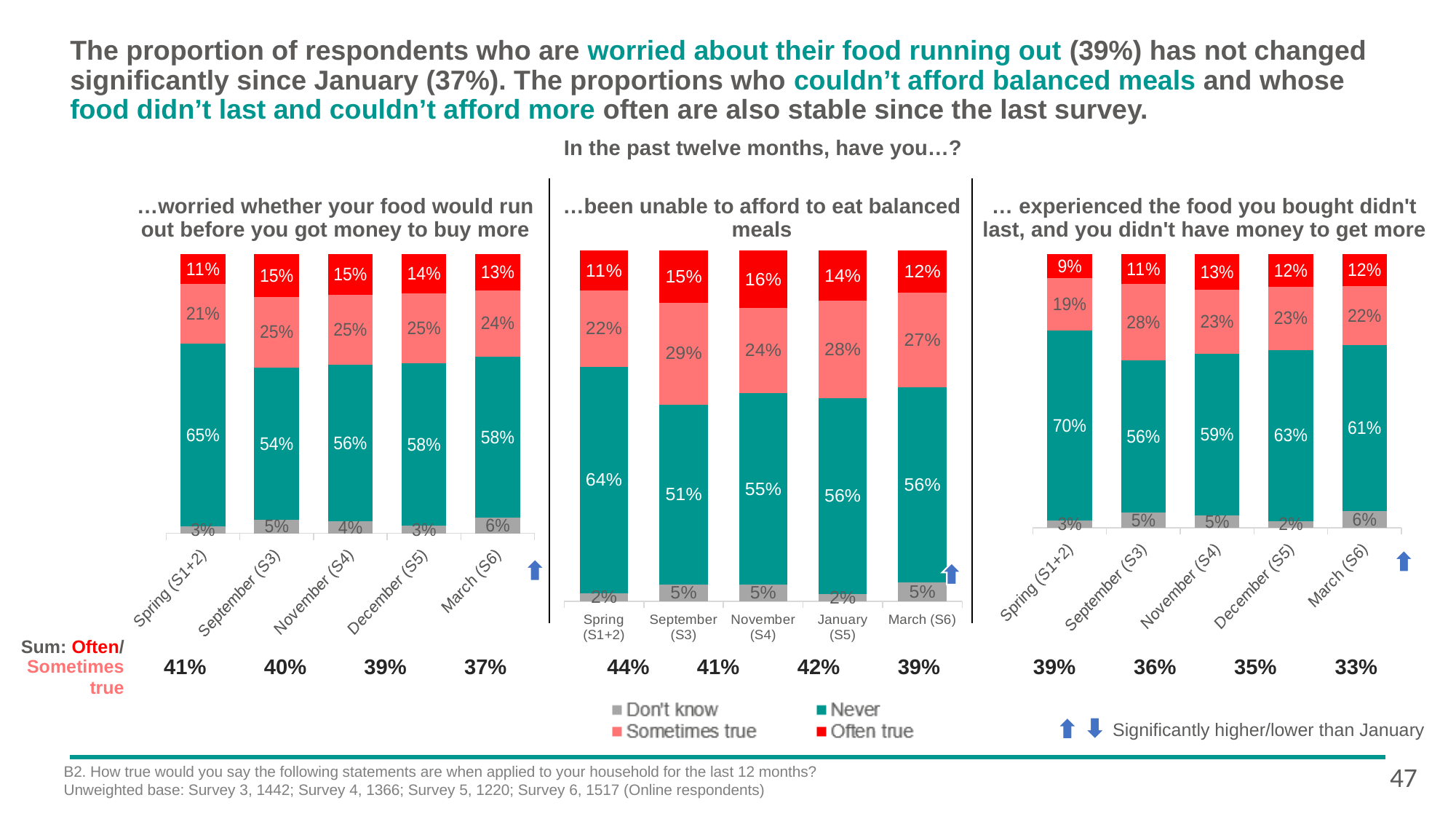
In the chart '…worried whether your food would run out before you got money to buy more', what is the 'Never' value for Spring (S1+2)? 65% How many categories are shown on the x axis of the chart '…been unable to afford to eat balanced meals'? 5 In the chart '… experienced the food you bought didn't last, and you didn't have money to get more', what is the 'Never' value for December (S5)? 63% How many series does the legend list? 4 In the chart '…been unable to afford to eat balanced meals', which category has the highest 'Never' value? Spring (S1+2) In the chart '…worried whether your food would run out before you got money to buy more', what is the 'Often true' value for September (S3)? 15% In the chart '… experienced the food you bought didn't last, and you didn't have money to get more', what is the 'Sometimes true' value for September (S3)? 28% In the chart '…been unable to afford to eat balanced meals', what is the 'Sometimes true' value for September (S3)? 29% In the chart '…been unable to afford to eat balanced meals', is the 'Often true' value larger for November (S4) or March (S6)? November (S4) In the chart '…worried whether your food would run out before you got money to buy more', what is the difference between the 'Never' values for Spring (S1+2) and September (S3)? 11% What kind of chart is used for '… experienced the food you bought didn't last, and you didn't have money to get more'? Stacked bar chart In the chart '… experienced the food you bought didn't last, and you didn't have money to get more', which category has the lowest 'Often true' value? Spring (S1+2)